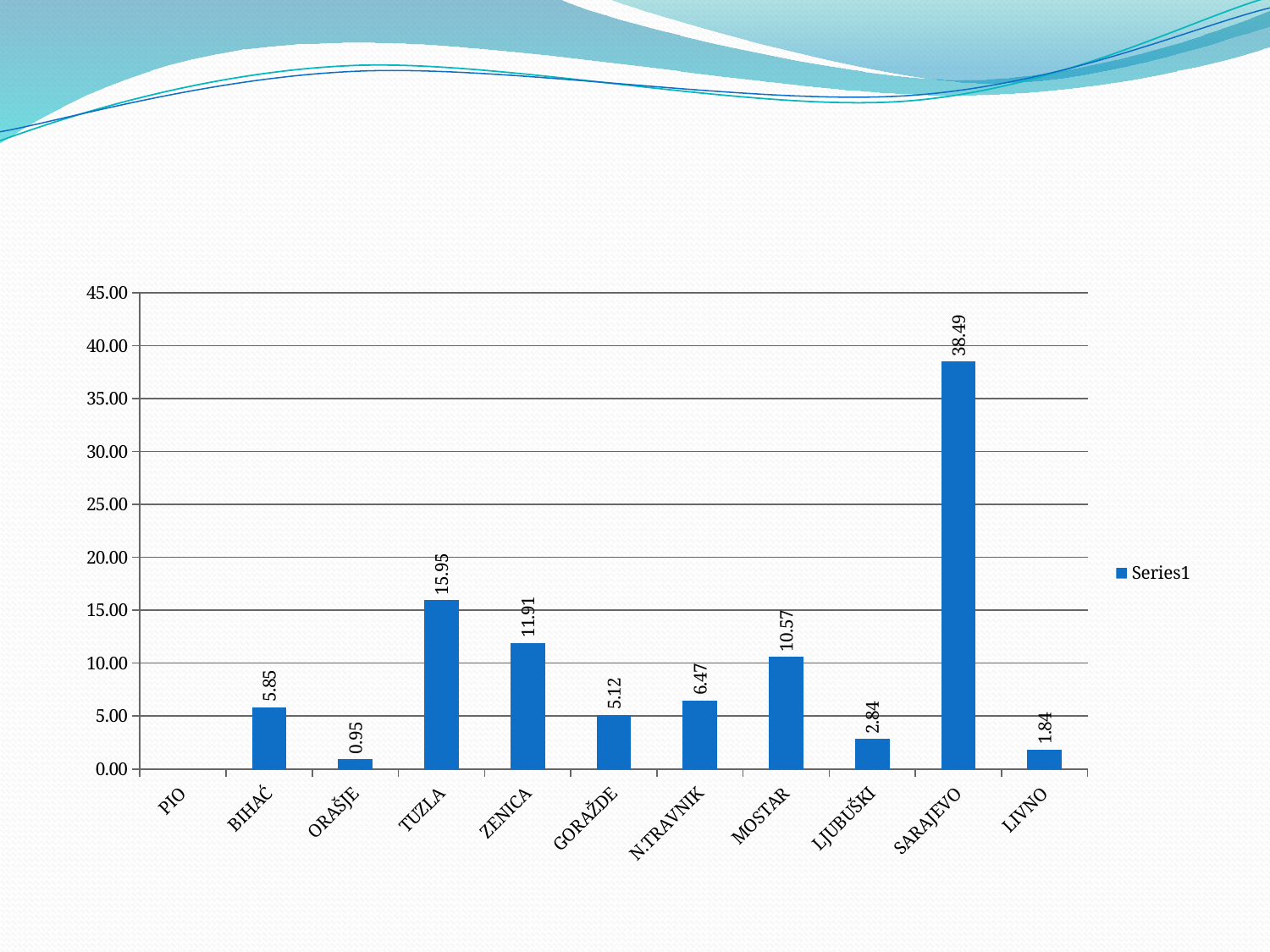
Which is larger, the value for BIHAĆ or the value for GORAŽDE? BIHAĆ How many categories are shown on the x axis? 11 What is the difference between the values for TUZLA and ZENICA? 4.04 Is the value for SARAJEVO greater or less than 35.00? greater What is the value for MOSTAR? 10.57 What is the difference between the values for SARAJEVO and TUZLA? 22.54 What kind of chart is shown on the slide? bar chart What is the value for SARAJEVO? 38.49 What is the value for TUZLA? 15.95 What is the value for ORAŠJE? 0.95 How many series does the legend list? 1 Which category has the highest value? SARAJEVO